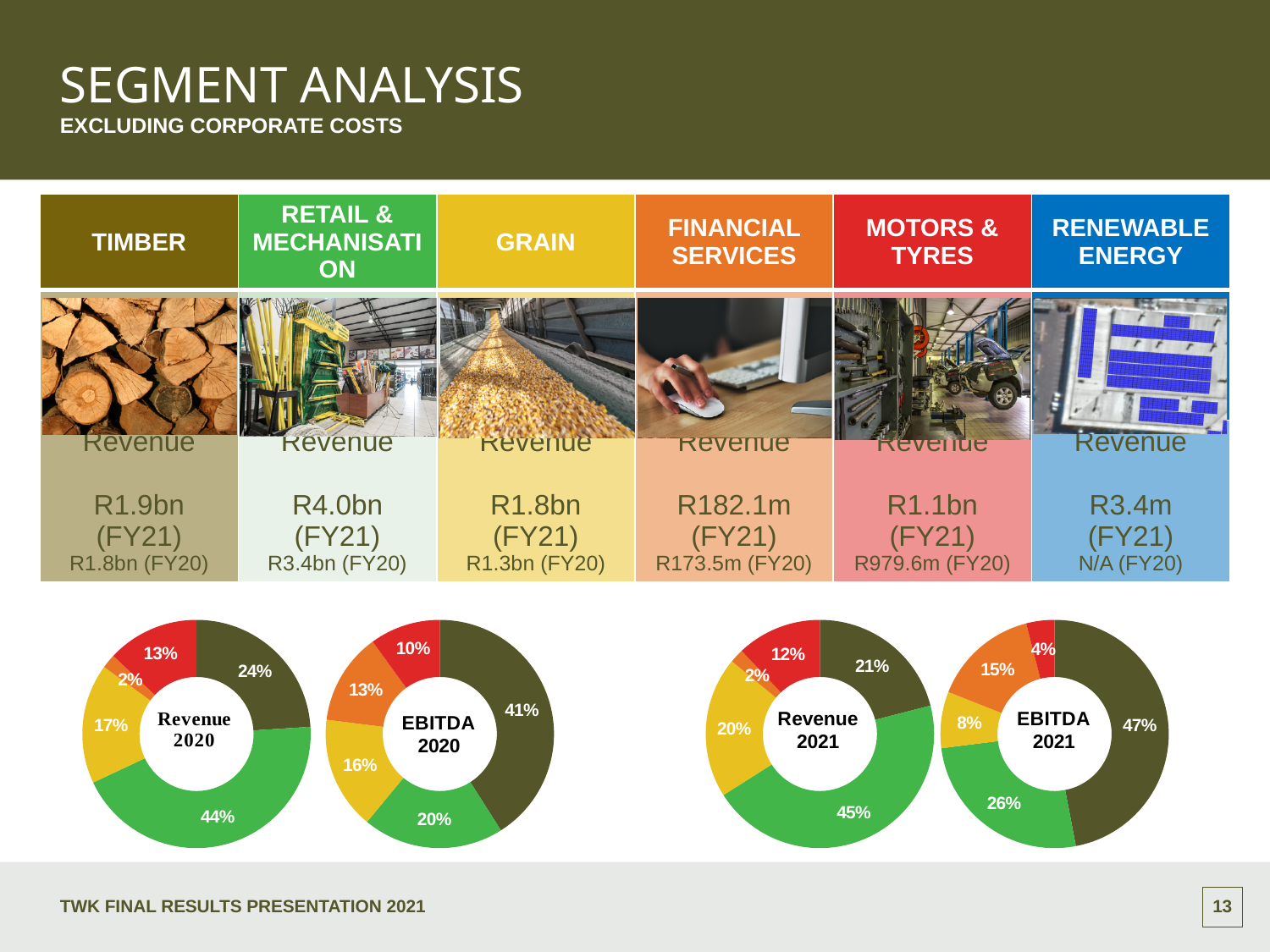
How many doughnut charts are shown on the slide? 4 In the Revenue 2020 chart, how many slices are there? 5 In the EBITDA 2020 chart, what is the largest slice's share? 41% In the EBITDA 2021 chart, what share does the dark olive slice represent? 47% In the EBITDA 2021 chart, what is the smallest slice's share? 4% In the Revenue 2021 chart, what is the difference between the largest slice (45%) and the 21% slice? 24 percentage points Which chart has the larger largest slice, EBITDA 2020 or EBITDA 2021? EBITDA 2021 In the Revenue 2021 chart, what is the largest slice's share? 45% In the Revenue 2020 chart, what is the largest slice's share? 44% In the Revenue 2020 chart, what is the smallest slice's share? 2% What kind of chart is the Revenue 2020 chart? doughnut chart In the EBITDA 2020 chart, what is the smallest slice's share? 10%